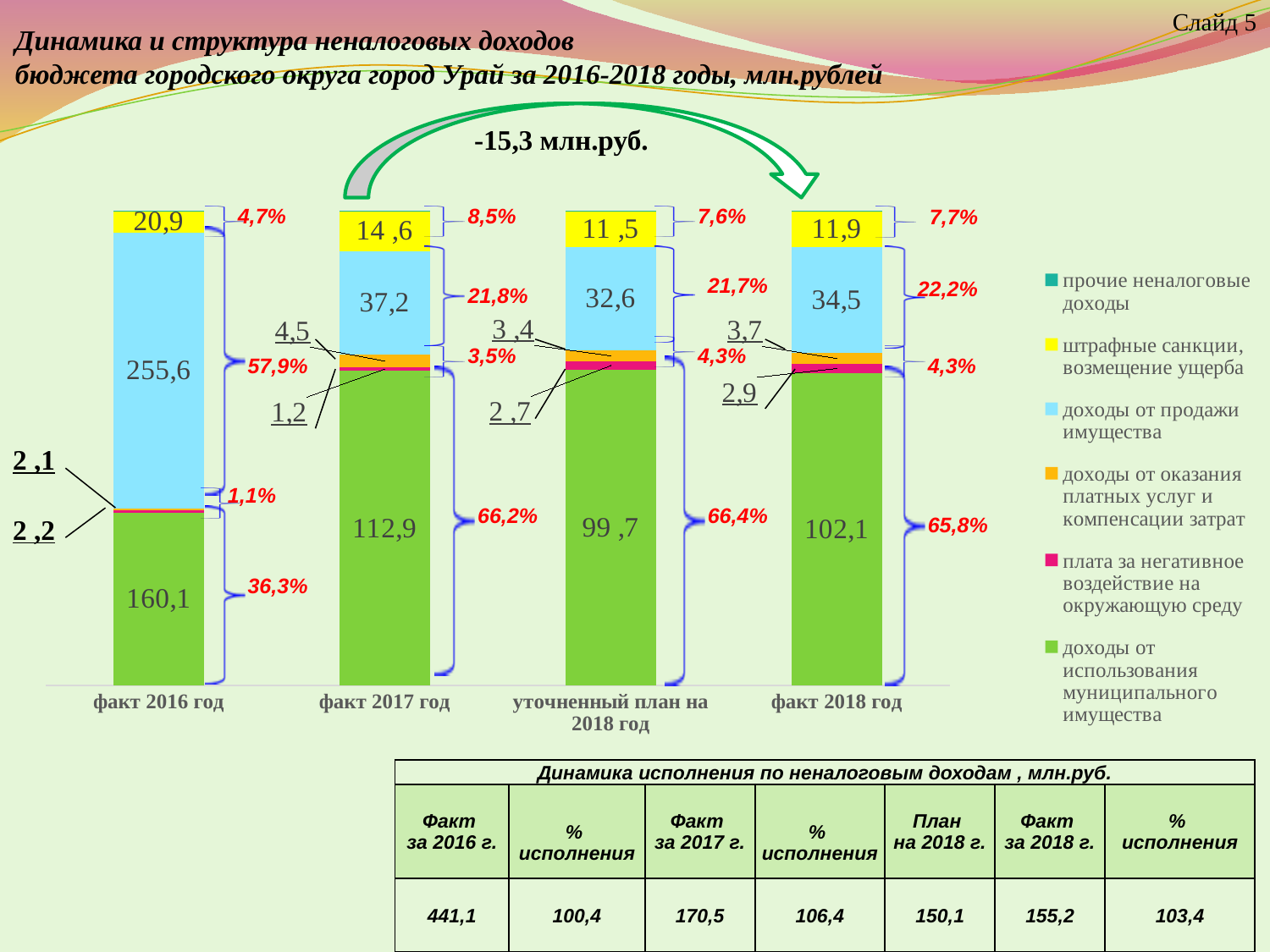
What is the value of доходы от использования муниципального имущества (green segment) for факт 2016 год? 160,1 What percentage share is shown for the green segment (доходы от использования муниципального имущества) in факт 2018 год? 65,8% What is the value of доходы от продажи имущества (blue segment) for факт 2017 год? 37,2 Which category has the highest value for доходы от продажи имущества (blue segment)? факт 2016 год How many series does the legend list? 6 What kind of chart is shown on the slide? Stacked bar chart What is the difference between the yellow segment values for факт 2016 год and факт 2017 год? 6,3 Which category has the lowest value for штрафные санкции, возмещение ущерба (yellow segment)? уточненный план на 2018 год Which is larger: the green segment for факт 2017 год or for факт 2018 год? факт 2017 год What is the value of штрафные санкции, возмещение ущерба (yellow segment) for факт 2018 год? 11,9 What is the difference between the blue segment values for факт 2016 год and факт 2018 год? 221,1 How many categories are shown on the x axis of the chart? 4